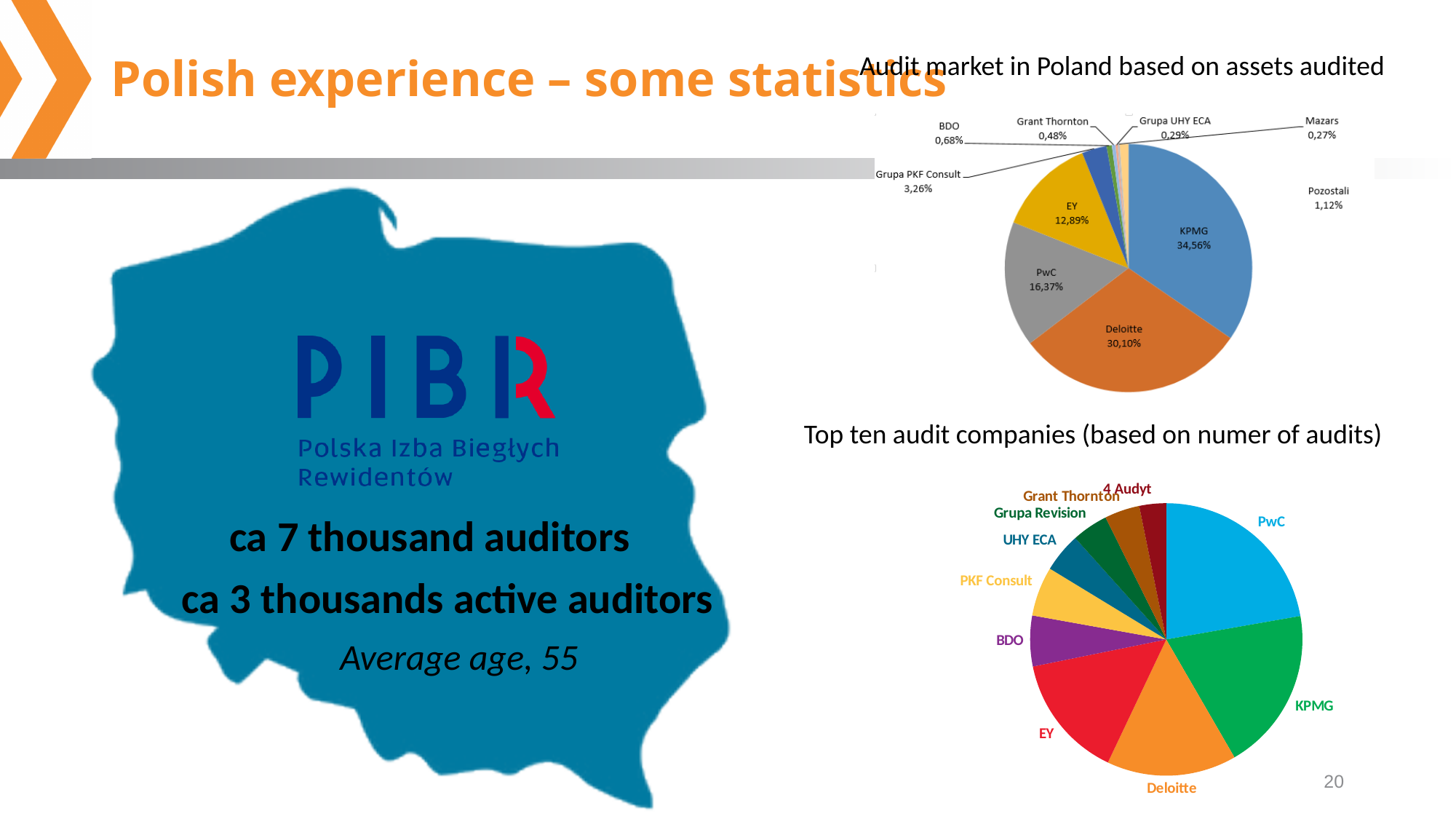
In the 'Audit market in Poland based on assets audited' chart, which company has the smallest share? Mazars In the 'Top ten audit companies (based on numer of audits)' chart, which company has the largest slice? PwC In the 'Audit market in Poland based on assets audited' chart, which company has the largest share? KPMG In the 'Audit market in Poland based on assets audited' chart, what share does EY have? 12,89% How many companies are shown in the 'Top ten audit companies (based on numer of audits)' chart? 10 In the 'Audit market in Poland based on assets audited' chart, what share does Grupa PKF Consult have? 3,26% In the 'Audit market in Poland based on assets audited' chart, what share does KPMG have? 34,56% In the 'Audit market in Poland based on assets audited' chart, which has a larger share, PwC or EY? PwC In the 'Audit market in Poland based on assets audited' chart, what is the difference between the shares of KPMG and Deloitte? 4,46% In the 'Audit market in Poland based on assets audited' chart, what share does Deloitte have? 30,10% How many slices does the 'Audit market in Poland based on assets audited' chart have? 10 What kind of chart is 'Top ten audit companies (based on numer of audits)'? Pie chart